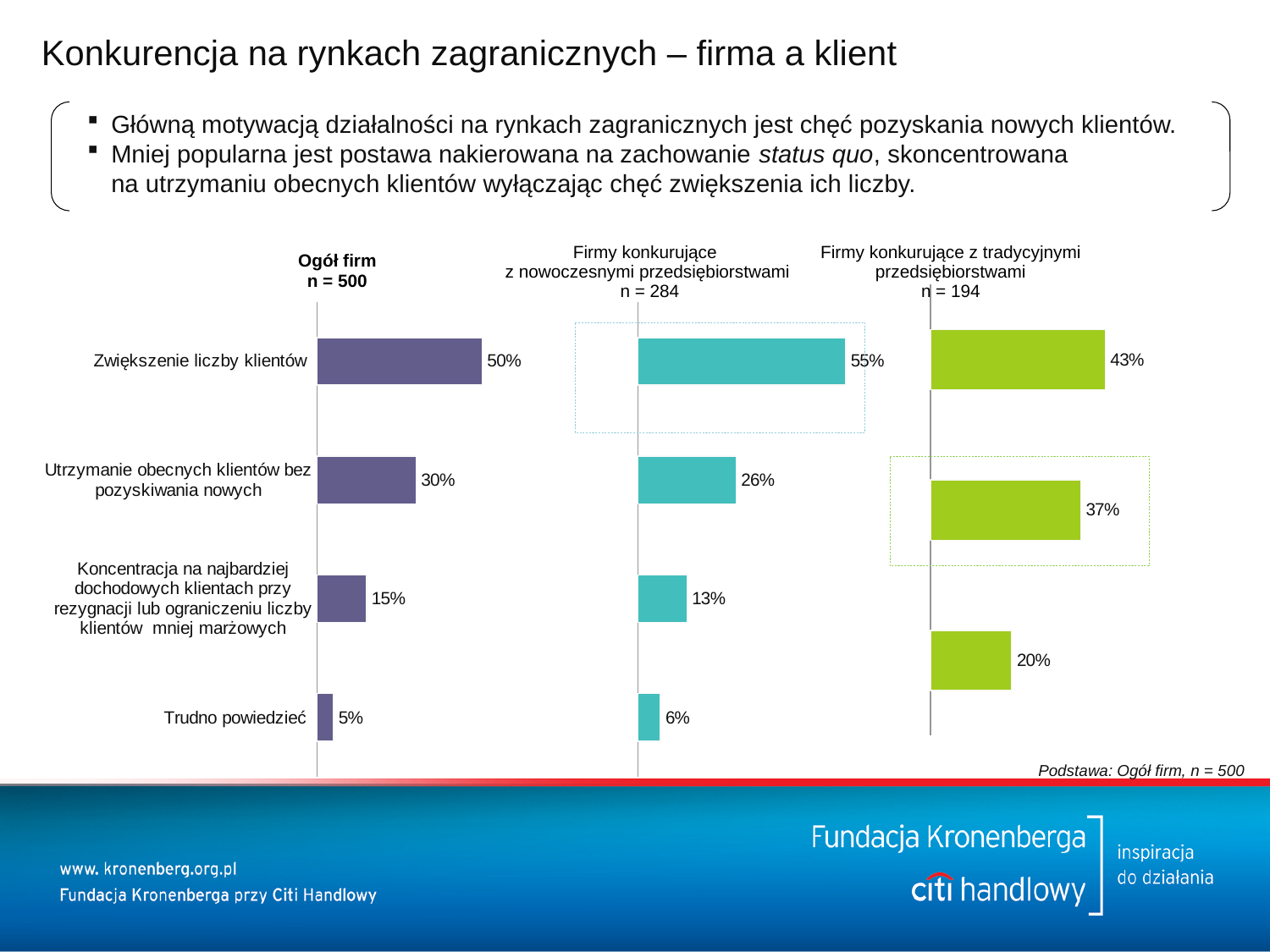
What is the sample size (n) given for the 'Firmy konkurujące z nowoczesnymi przedsiębiorstwami' chart? n = 284 What is the difference between the 'Zwiększenie liczby klientów' values in the 'Firmy konkurujące z nowoczesnymi przedsiębiorstwami' chart and the 'Firmy konkurujące z tradycyjnymi przedsiębiorstwami' chart? 12 percentage points In the 'Firmy konkurujące z tradycyjnymi przedsiębiorstwami' chart, which category has the highest value? Zwiększenie liczby klientów In the 'Ogół firm' chart, what is the difference between 'Zwiększenie liczby klientów' and 'Utrzymanie obecnych klientów bez pozyskiwania nowych'? 20 percentage points In the 'Firmy konkurujące z nowoczesnymi przedsiębiorstwami' chart, which category has the lowest value? Trudno powiedzieć In the 'Firmy konkurujące z nowoczesnymi przedsiębiorstwami' chart, what is the value for 'Utrzymanie obecnych klientów bez pozyskiwania nowych'? 26% In the 'Ogół firm' chart, what is the value for 'Zwiększenie liczby klientów'? 50% What type of chart is used on this slide? Bar chart In the 'Firmy konkurujące z tradycyjnymi przedsiębiorstwami' chart, what is the value for 'Utrzymanie obecnych klientów bez pozyskiwania nowych'? 37% Which is larger: the 'Koncentracja na najbardziej dochodowych klientach...' value in the 'Firmy konkurujące z nowoczesnymi przedsiębiorstwami' chart or in the 'Firmy konkurujące z tradycyjnymi przedsiębiorstwami' chart? Firmy konkurujące z tradycyjnymi przedsiębiorstwami (20%) How many bars are shown in the 'Ogół firm' chart? 4 In the 'Ogół firm' chart, what is the value for 'Trudno powiedzieć'? 5%